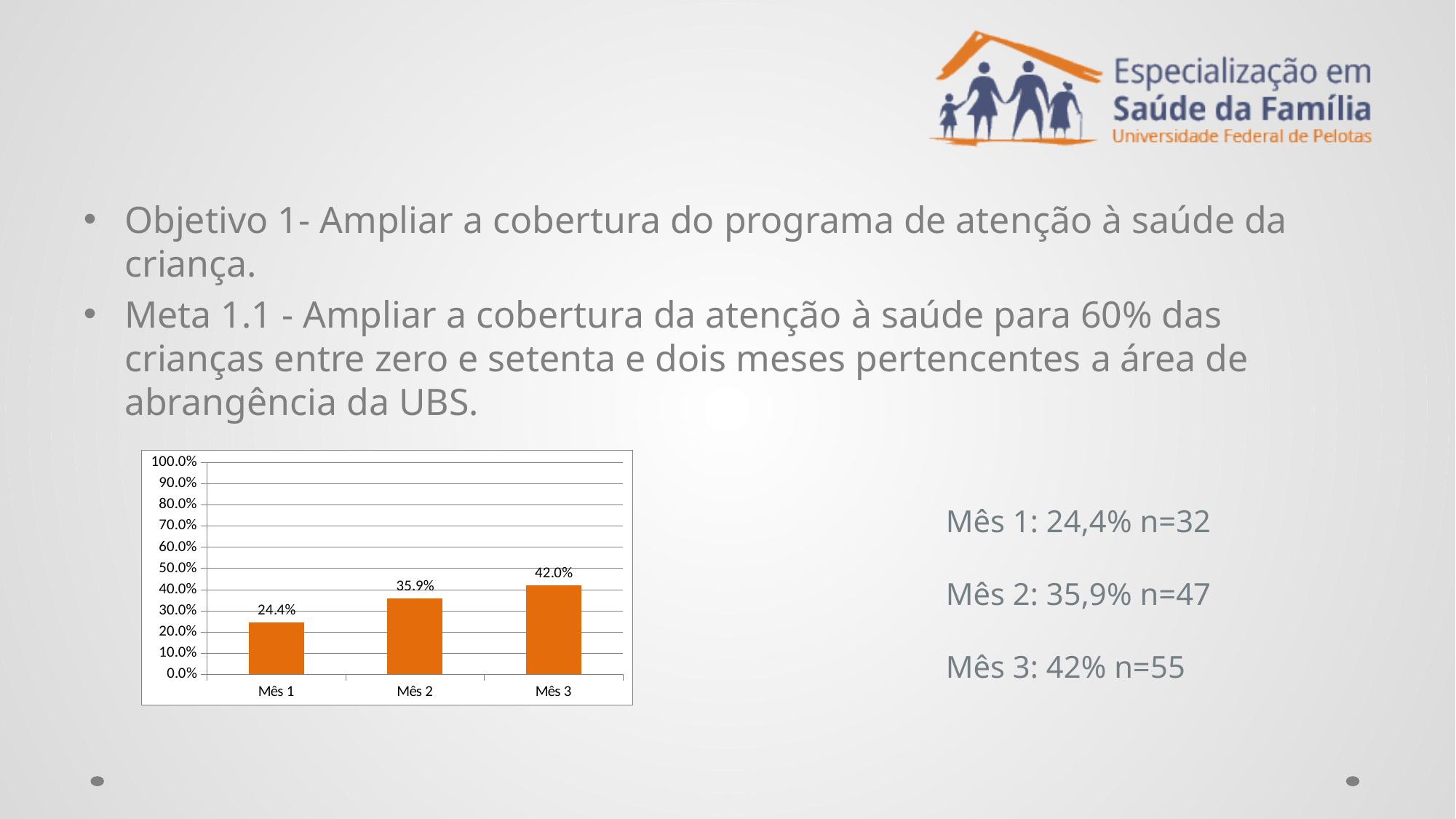
What is the difference between the values for Mês 3 and Mês 1? 17.6% Do the values rise or fall from Mês 1 to Mês 3? rise What is the value for Mês 1? 24.4% Which is larger, the value for Mês 2 or the value for Mês 3? Mês 3 Which month has the lowest value? Mês 1 What is the difference between the values for Mês 2 and Mês 1? 11.5% What is the value for Mês 3? 42.0% How many categories are shown on the x axis? 3 What is the value for Mês 2? 35.9% What kind of chart is shown on the slide? bar chart Which month has the highest value? Mês 3 Is the value for Mês 3 greater or less than 50.0%? less